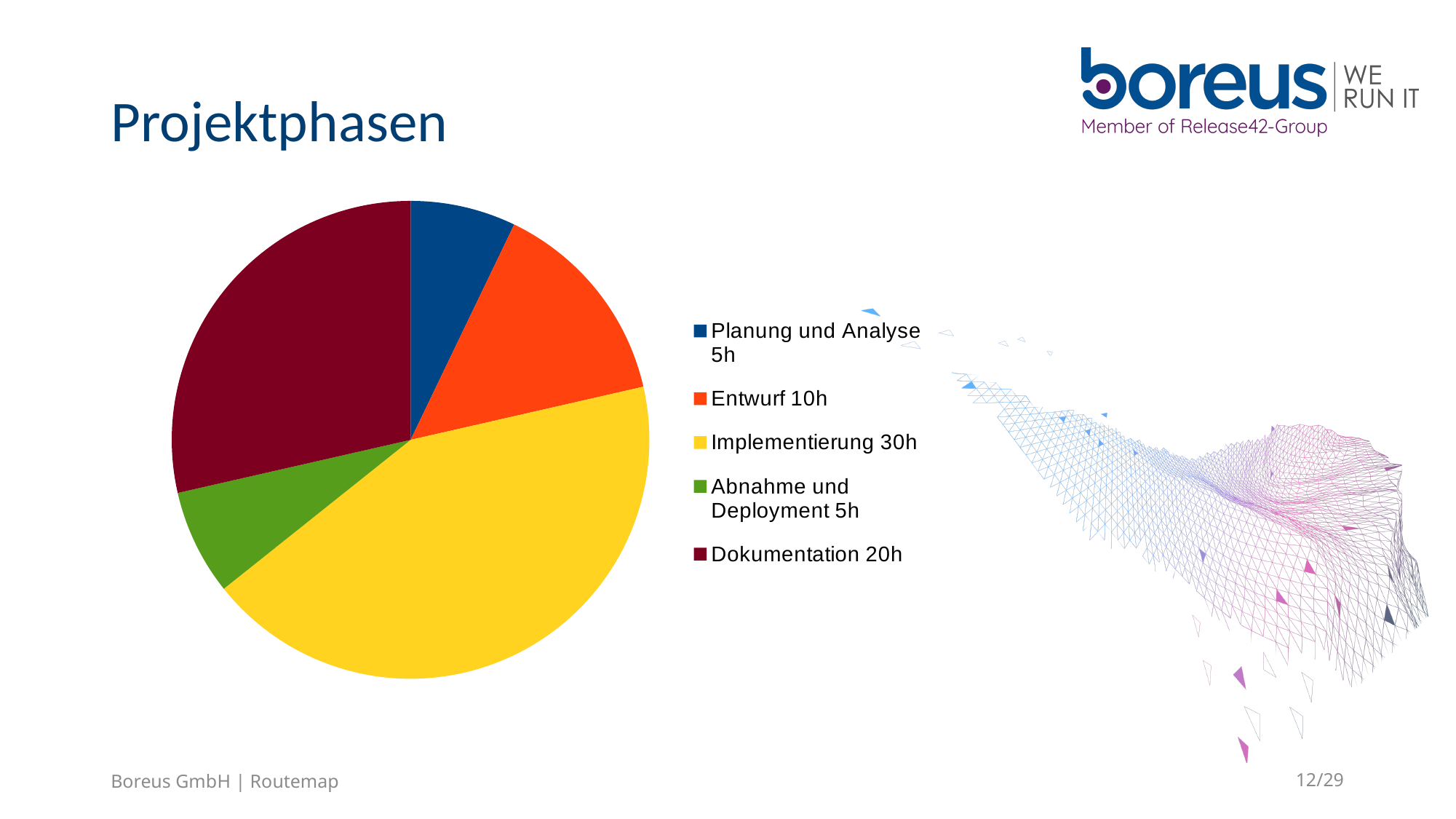
Which has more hours, Entwurf or Dokumentation? Dokumentation How many hours are shown for Abnahme und Deployment? 5h What kind of chart is shown on the slide? pie chart How many hours are shown for Dokumentation? 20h How many hours are shown for Entwurf? 10h How many hours are shown for Implementierung? 30h What colour is the Implementierung slice in the pie chart? yellow How many hours are shown for Planung und Analyse? 5h How many categories does the pie chart have? 5 Which project phase has the largest share of the pie? Implementierung What is the difference in hours between Implementierung and Dokumentation? 10h What is the title of the chart slide? Projektphasen